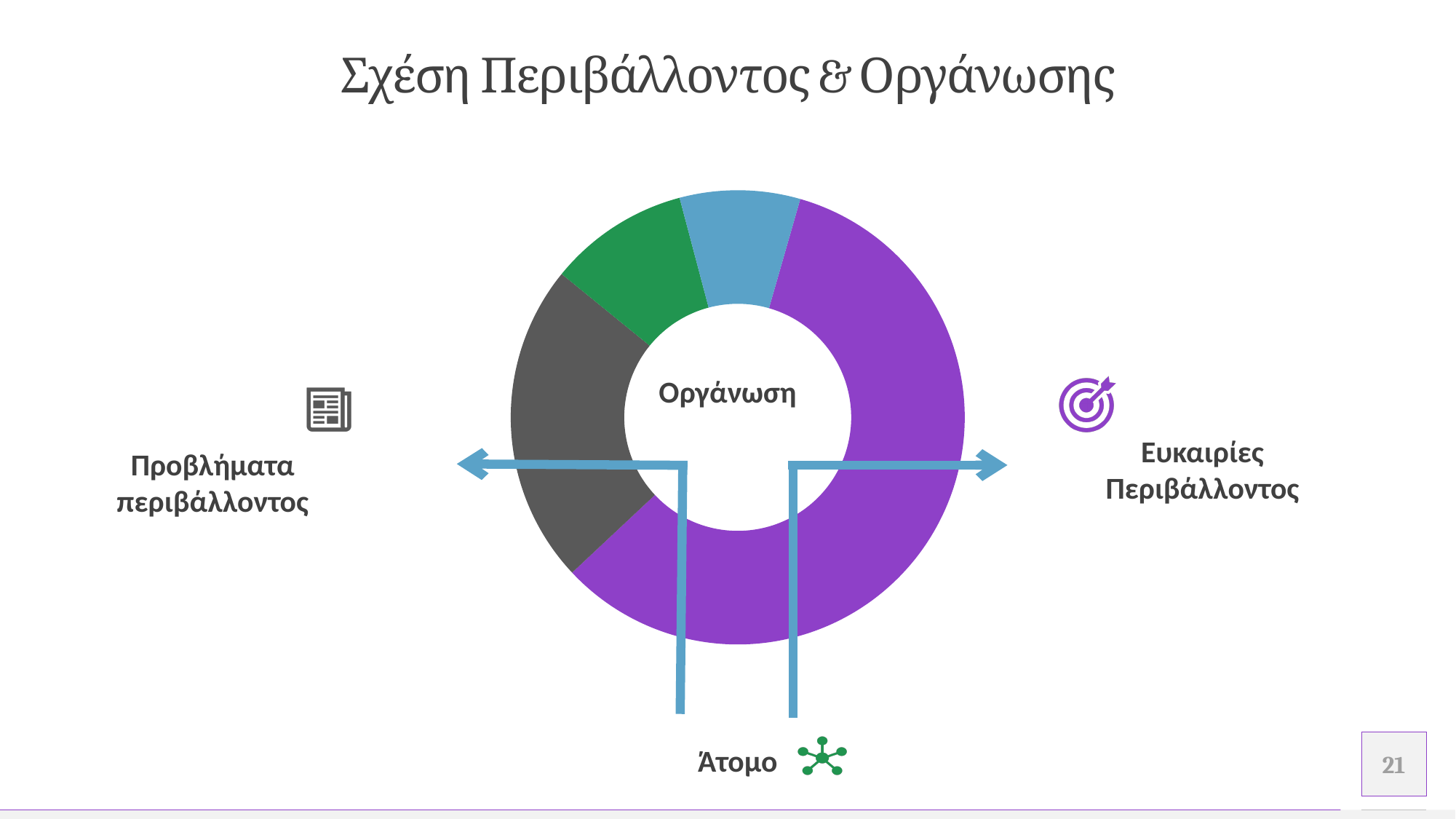
Which colour segment of the doughnut chart is the smallest? blue Is the purple segment of the doughnut chart larger or smaller than the green segment? larger What is the title of the slide containing the doughnut chart? Σχέση Περιβάλλοντος & Οργάνωσης How many segments does the doughnut chart have? 4 What kind of chart is shown on the slide? doughnut chart Is the gray segment of the doughnut chart larger or smaller than the blue segment? larger Which colour segment of the doughnut chart is the largest? purple What text is written in the centre of the doughnut chart? Οργάνωση